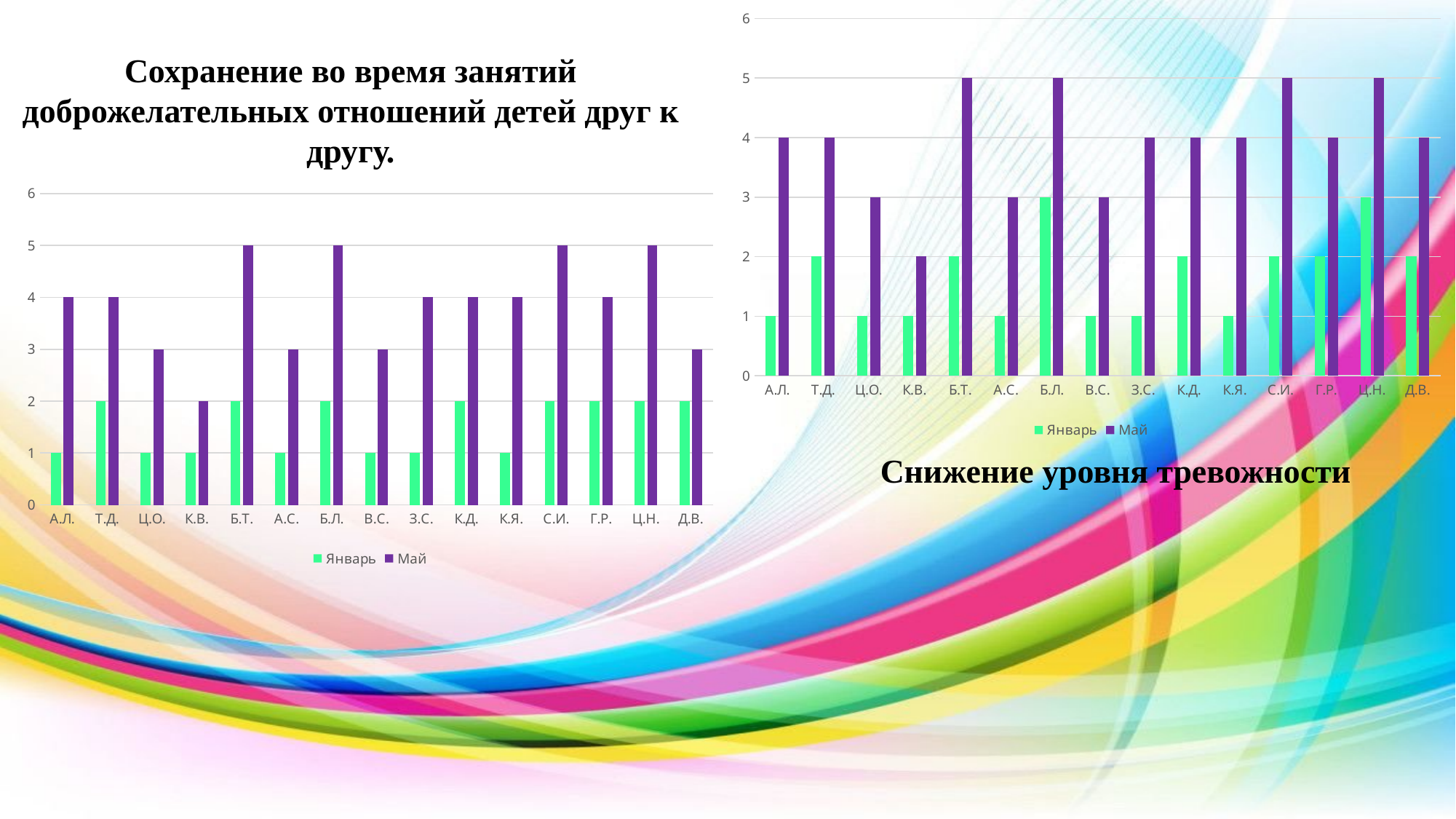
On the right chart (Снижение уровня тревожности), what is the value for Январь for Б.Л.? 3 How many categories are shown on the x axis of the left chart (Сохранение во время занятий доброжелательных отношений детей друг к другу)? 15 On the right chart (Снижение уровня тревожности), what is the value for Май for К.В.? 2 On the left chart (Сохранение во время занятий доброжелательных отношений детей друг к другу), what is the value for Май for Б.Т.? 5 On the left chart (Сохранение во время занятий доброжелательных отношений детей друг к другу), what is the value for Январь for Т.Д.? 2 On the left chart (Сохранение во время занятий доброжелательных отношений детей друг к другу), which is larger for Ц.О., Январь or Май? Май What are the legend entries of the left chart (Сохранение во время занятий доброжелательных отношений детей друг к другу)? Январь, Май What kind of chart is the right chart (Снижение уровня тревожности)? Bar chart How many series does the legend of the right chart (Снижение уровня тревожности) list? 2 On the right chart (Снижение уровня тревожности), what is the difference between Май and Январь for А.Л.? 3 On the right chart (Снижение уровня тревожности), is the value for Май for Ц.Н. greater or less than 3? greater On the left chart (Сохранение во время занятий доброжелательных отношений детей друг к другу), which series has the lowest value for К.В.? Январь